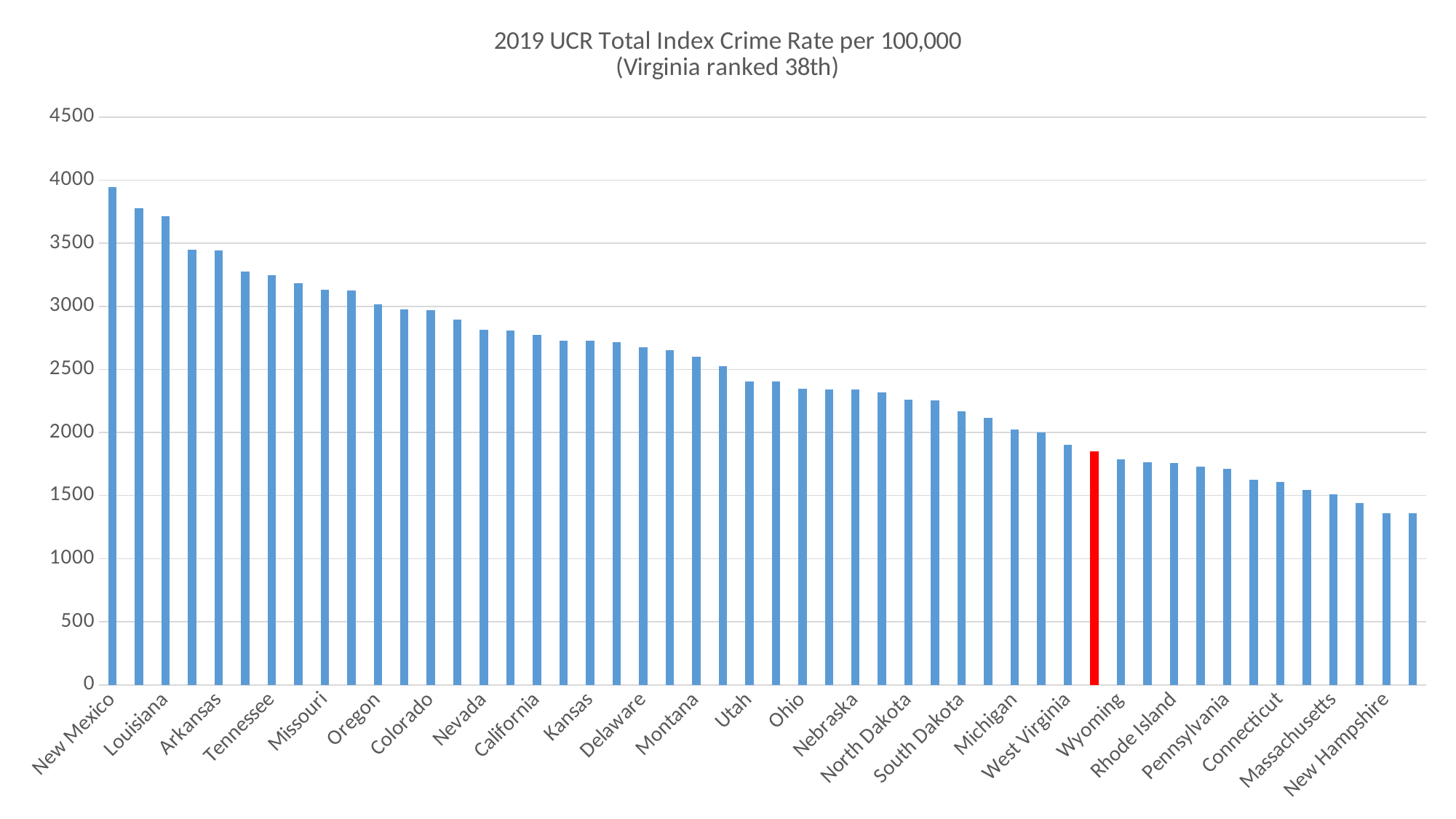
Which state is highlighted with a red bar? Virginia Do the values rise or fall moving from left to right along the x axis? fall Which state has the highest crime rate in the chart? New Mexico Is the value for Wyoming greater or less than 2000? less Is the value for the red bar (Virginia) greater or less than 2000? less Is the value for New Mexico greater or less than 3500? greater What kind of chart is shown on the slide? bar chart Which has a higher crime rate, New Mexico or Louisiana? New Mexico What is the title of the chart? 2019 UCR Total Index Crime Rate per 100,000 (Virginia ranked 38th)